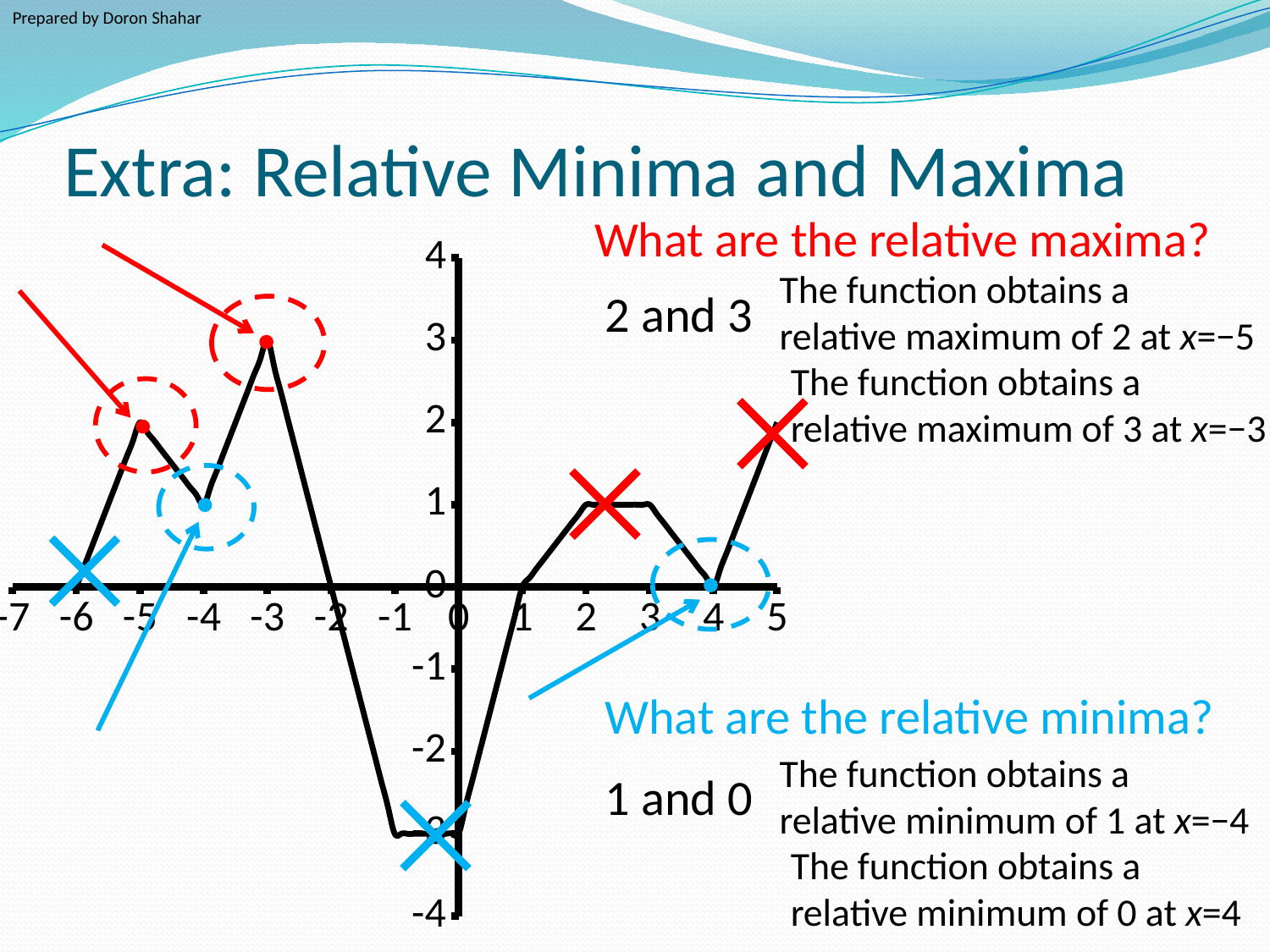
What kind of chart is shown on the slide? line chart What is the title of the slide containing the graph? Extra: Relative Minima and Maxima Is the function value at x=−1 greater or less than 0? less What are the relative minima of the function, according to the slide? 1 and 0 At what x-value does the function obtain a relative maximum of 3? x=−3 Which is larger, the function value at x=−3 or at x=−5? x=−3 What is the difference between the relative maximum at x=−3 and the relative maximum at x=−5? 1 At what x-value does the function obtain a relative maximum of 2? x=−5 What are the relative maxima of the function, according to the slide? 2 and 3 What is the value of the function at x=4? 0 Is the function value at x=5 greater or less than 1? greater What is the value of the function at x=−4? 1